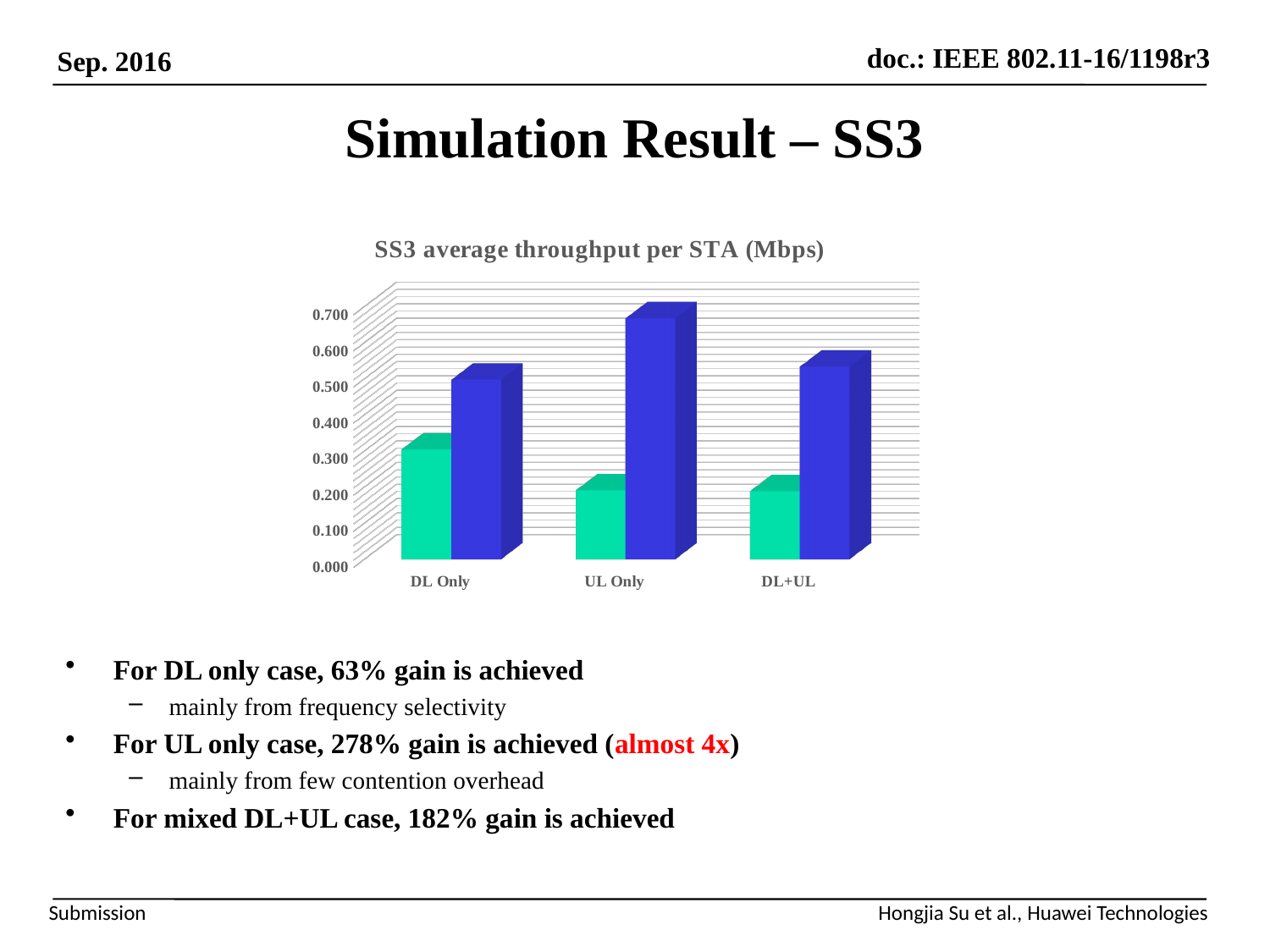
Which category has the tallest blue bar? UL Only Which category has the lowest blue bar? DL Only Is the blue bar for DL+UL greater or less than 0.400? greater For the DL Only category, which bar is taller, the green one or the blue one? blue How many categories are shown on the x axis of the chart? 3 What type of chart is shown on the slide? bar chart Which category has the tallest green bar? DL Only Is the green bar for DL Only greater or less than 0.200? greater Is the blue bar for UL Only greater or less than 0.600? greater What is the title of the chart? SS3 average throughput per STA (Mbps) How many bars are plotted for each category in the chart? 2